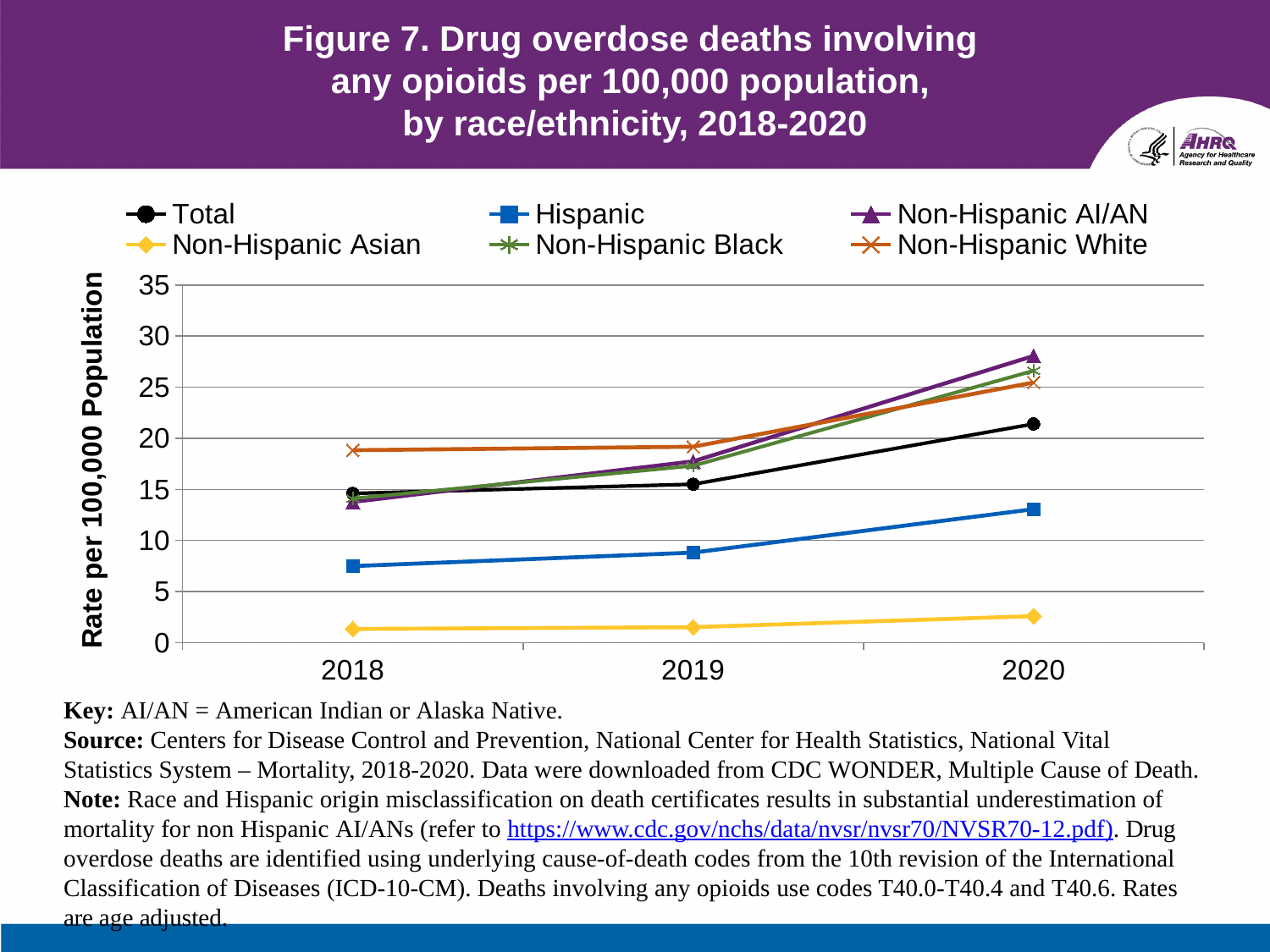
Does the Total rate rise or fall from 2018 to 2020? rise Which race/ethnicity group has the highest rate in 2018? Non-Hispanic White Which race/ethnicity group has the lowest rate in 2020? Non-Hispanic Asian Is the value for Non-Hispanic White in 2018 greater or less than 15? greater What kind of chart is shown on the slide? line chart Is the value for Non-Hispanic Asian in 2020 greater or less than 5? less How many years are plotted along the x axis? 3 What is the label on the y axis? Rate per 100,000 Population Is the value for Hispanic in 2020 greater or less than 10? greater In 2019, which is larger: the rate for Hispanic or the rate for Total? Total How many series does the legend list? 6